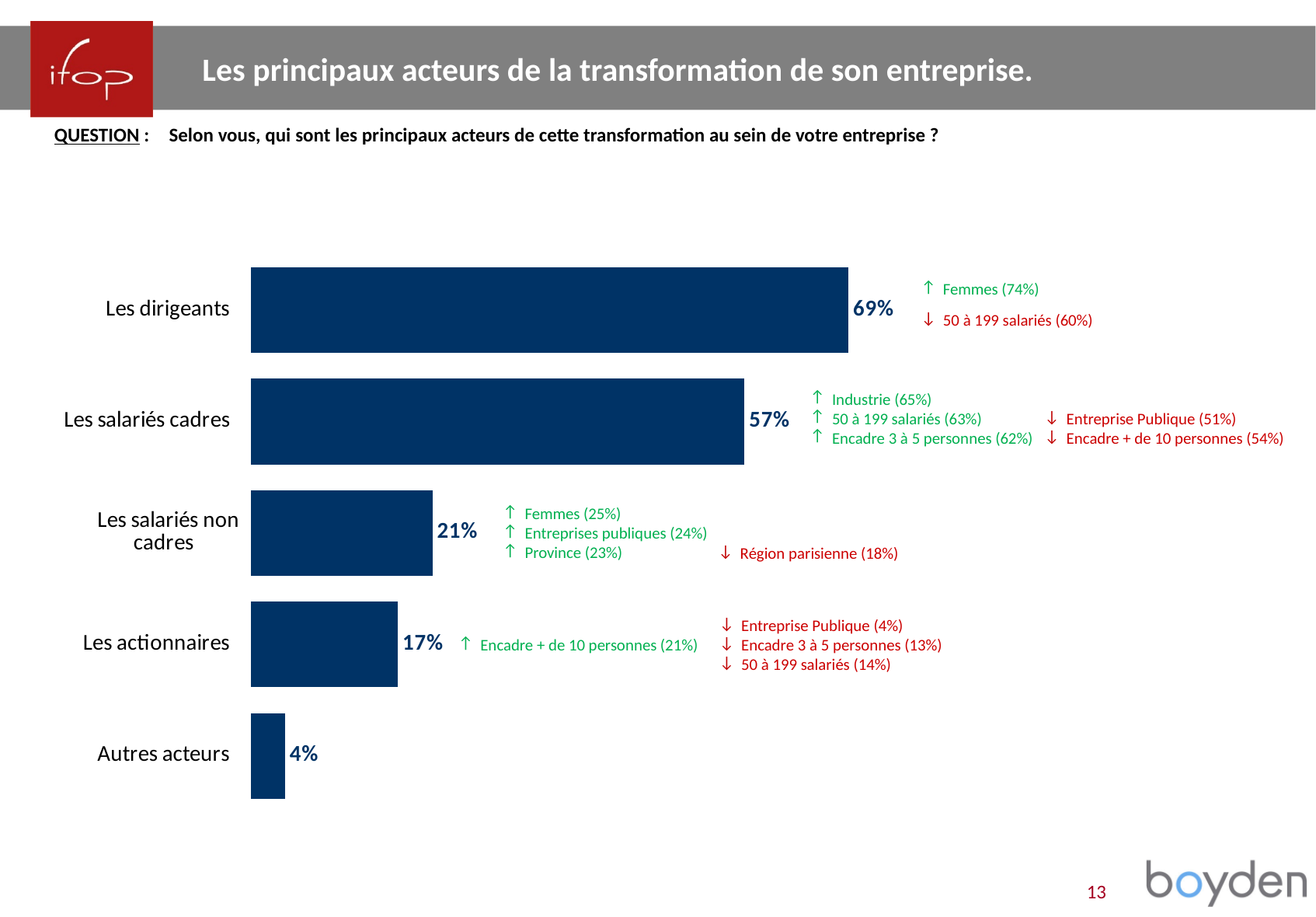
Which category has the lowest value? Autres acteurs What is the value for Les actionnaires? 17% What is the value for Les dirigeants? 69% What is the value for Les salariés non cadres? 21% How many categories are shown in the chart? 5 What is the value for Autres acteurs? 4% Which category has the highest value? Les dirigeants What is the difference between the values for Les salariés non cadres and Les actionnaires? 4% What is the value for Les salariés cadres? 57% What kind of chart is shown on the slide? Bar chart Which is larger, the value for Les salariés non cadres or the value for Les actionnaires? Les salariés non cadres What is the difference between the values for Les dirigeants and Les salariés cadres? 12%